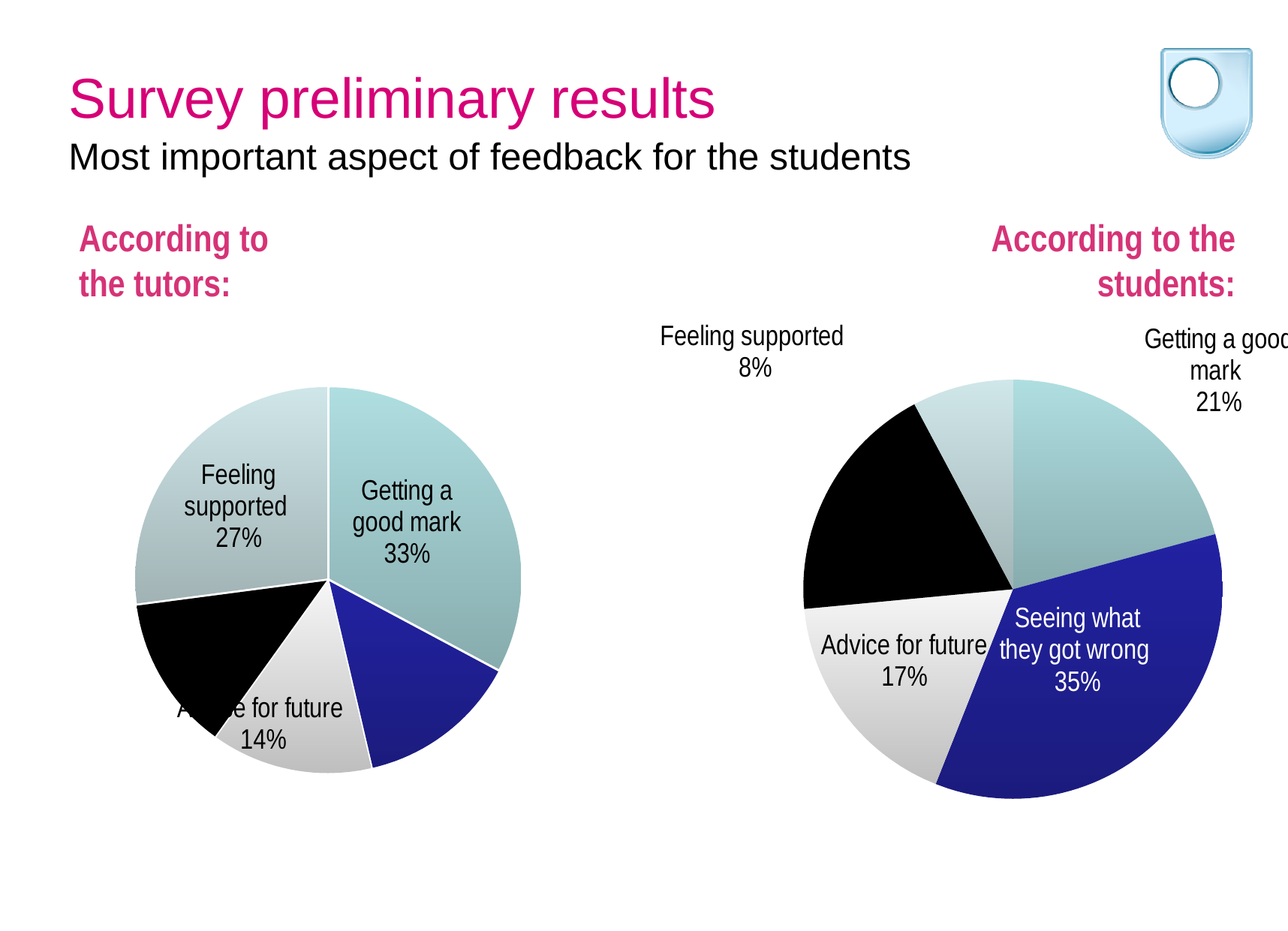
In the 'According to the tutors' pie chart, which category has the largest share? Getting a good mark In the 'According to the students' pie chart, what percentage is shown for 'Seeing what they got wrong'? 35% What is the difference in percentage points between 'Getting a good mark' in the tutors' chart and 'Getting a good mark' in the students' chart? 12 Which is larger: 'Feeling supported' in the tutors' chart or 'Feeling supported' in the students' chart? Tutors' chart In the 'According to the tutors' pie chart, what percentage is shown for 'Advice for future'? 14% In the 'According to the students' pie chart, which labelled category has the smallest share? Feeling supported What type of chart is used on this slide? Pie chart In the 'According to the students' pie chart, what percentage is shown for 'Getting a good mark'? 21% In the 'According to the tutors' pie chart, what percentage is shown for 'Feeling supported'? 27% In the 'According to the students' pie chart, which category has the largest share? Seeing what they got wrong In the 'According to the students' pie chart, what percentage is shown for 'Feeling supported'? 8% In the 'According to the tutors' pie chart, what percentage is shown for 'Getting a good mark'? 33%